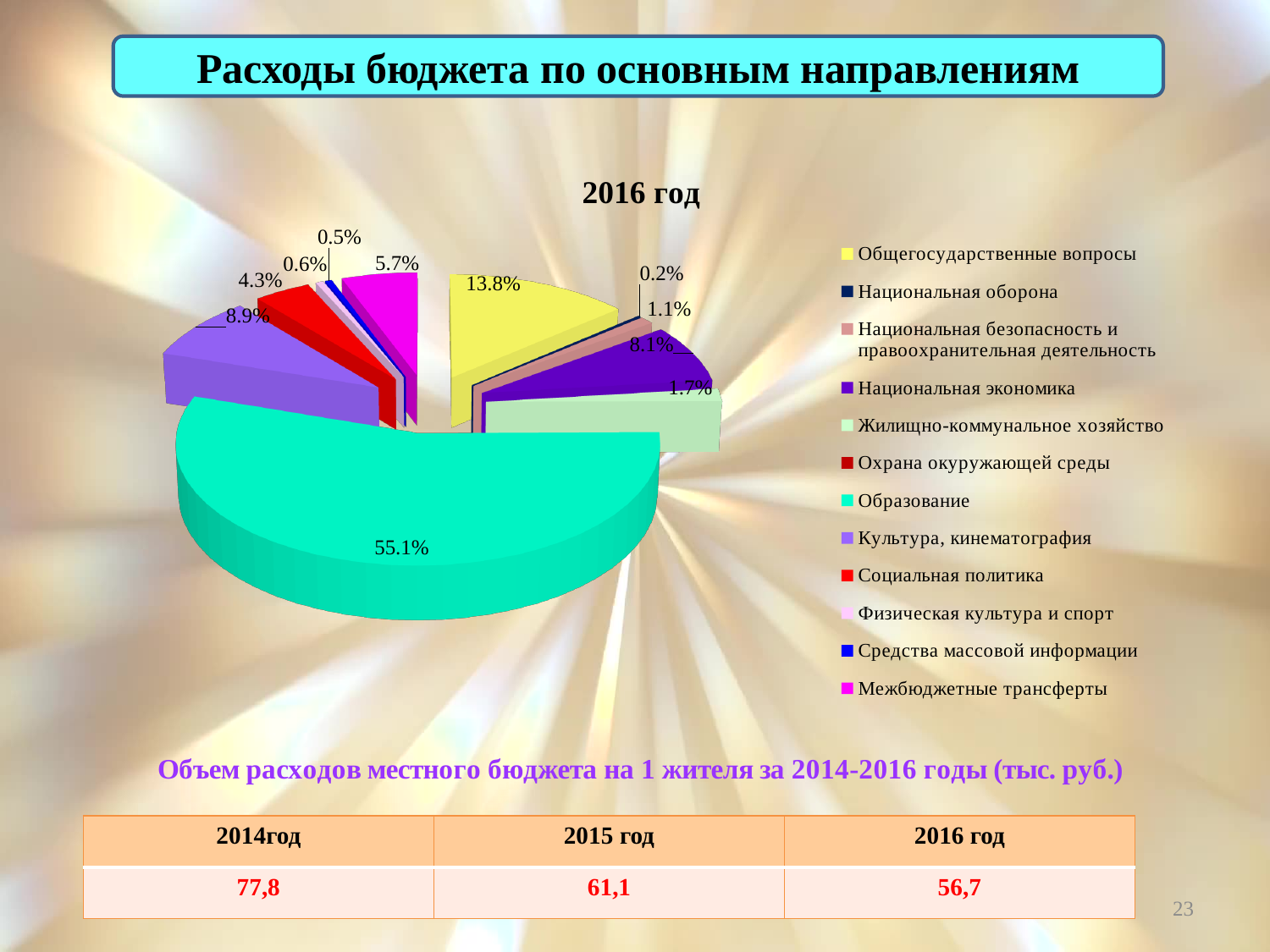
Which is larger, the share of Культура, кинематография or Национальная экономика? Культура, кинематография What is the value for Культура, кинематография? 8.9% How many entries does the legend list? 12 What is the value for Национальная экономика? 8.1% What share of the pie does Образование have? 55.1% What is the value for Общегосударственные вопросы? 13.8% What is the value for Межбюджетные трансферты? 5.7% What kind of chart is shown on the slide? Pie chart Which category has the largest slice of the pie? Образование What is the difference between the shares of Образование and Общегосударственные вопросы? 41.3% What is the title of the chart? 2016 год